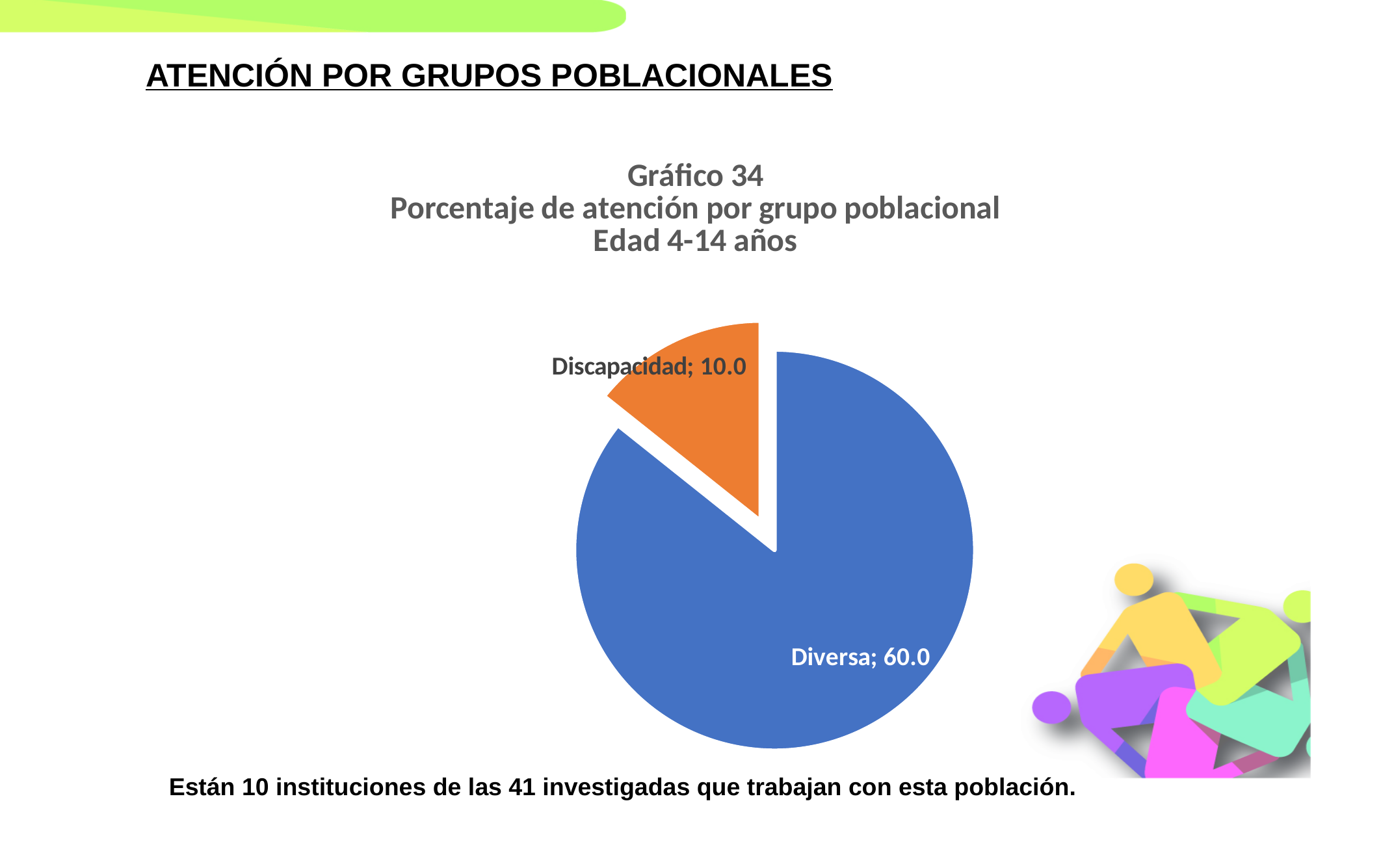
Which slice of the pie chart is the largest? Diversa What colour is the Discapacidad slice in the pie chart? orange What age range does the chart title refer to? 4-14 años What type of chart is shown on the slide? pie chart What is the value for Discapacidad in the pie chart? 10.0 What is the value for Diversa in the pie chart? 60.0 Which is larger, the value for Diversa or the value for Discapacidad? Diversa What is the title of the chart? Gráfico 34 Porcentaje de atención por grupo poblacional Edad 4-14 años What is the difference between the values for Diversa and Discapacidad? 50.0 Which slice of the pie chart is the smallest? Discapacidad How many slices does the pie chart have? 2